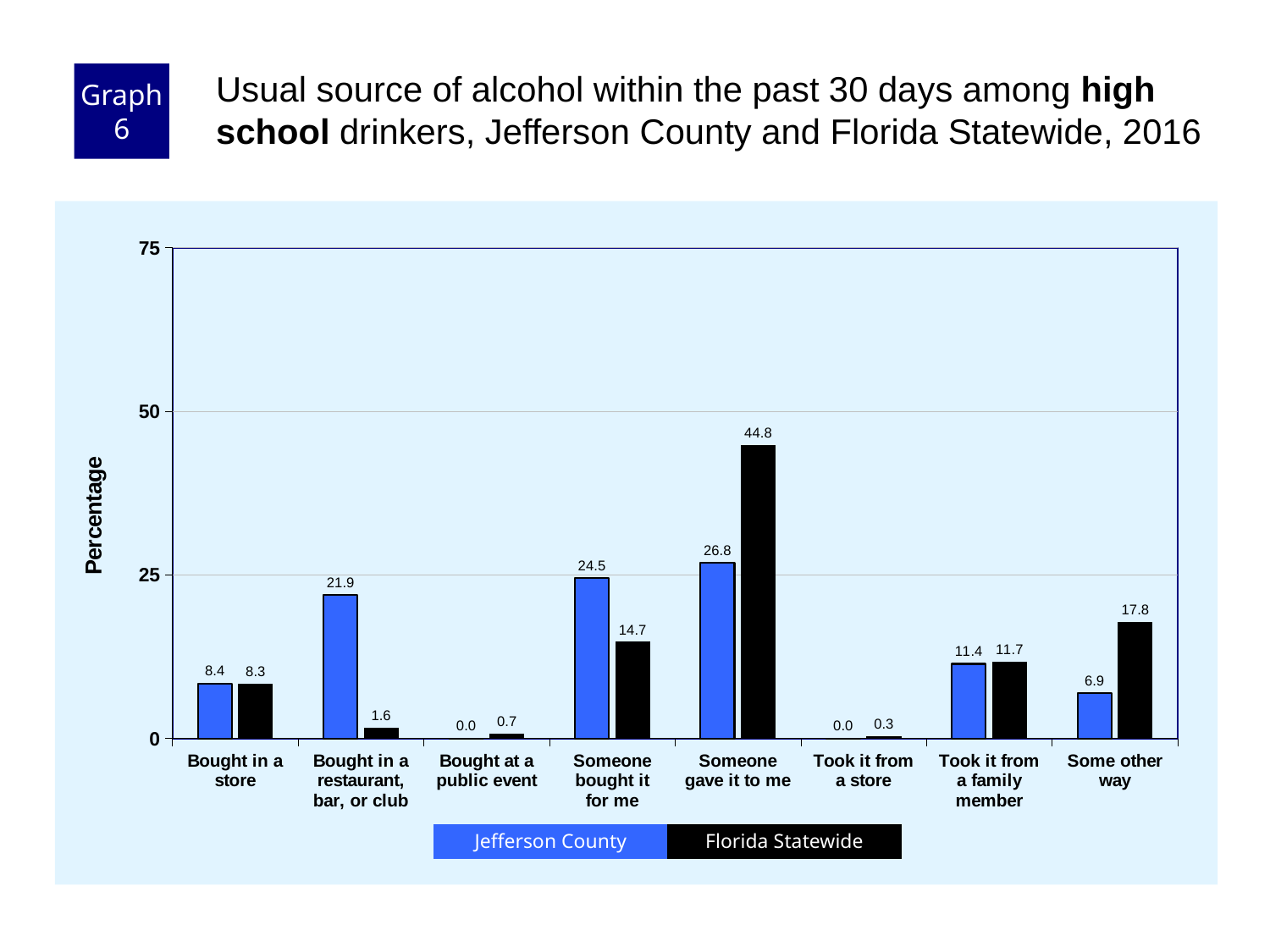
What is the label of the y axis? Percentage Is the Florida Statewide value for "Someone gave it to me" greater or less than 25? greater Which is larger for "Someone bought it for me": Jefferson County or Florida Statewide? Jefferson County What is the Jefferson County value for "Someone gave it to me"? 26.8 How many source categories are shown on the x axis? 8 What is the difference between the Florida Statewide and Jefferson County values for "Someone gave it to me"? 18.0 How many series does the legend list? 2 What kind of chart is shown on the slide? Bar chart What is the difference between the Jefferson County and Florida Statewide values for "Bought in a restaurant, bar, or club"? 20.3 What is the Florida Statewide value for "Bought in a restaurant, bar, or club"? 1.6 Which category has the highest Florida Statewide value? Someone gave it to me Which category has the lowest Jefferson County value? Bought at a public event and Took it from a store (both 0.0)